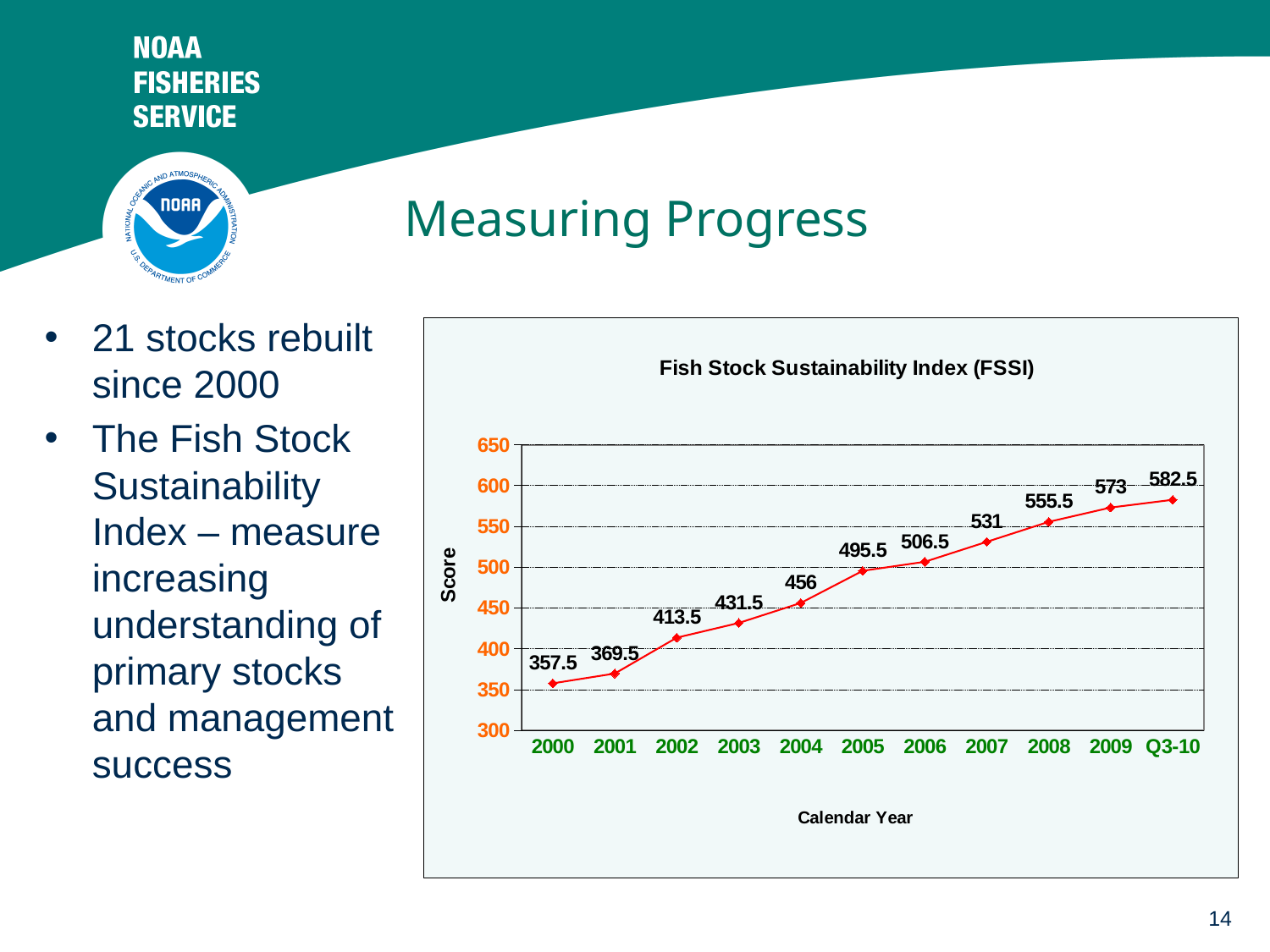
How many data points are plotted on the chart? 11 Do the FSSI scores rise or fall from 2000 to Q3-10? rise Which is larger, the FSSI score for 2004 or for 2005? 2005 What is the FSSI score for 2000? 357.5 Which year has the highest FSSI score? Q3-10 What is the FSSI score for Q3-10? 582.5 What is the difference between the FSSI score in Q3-10 and in 2000? 225 Which year has the lowest FSSI score? 2000 What is the FSSI score for 2006? 506.5 Is the FSSI score for 2007 greater or less than 500? greater What kind of chart is shown on the slide? line chart What is the difference between the FSSI score in 2009 and in 2008? 17.5